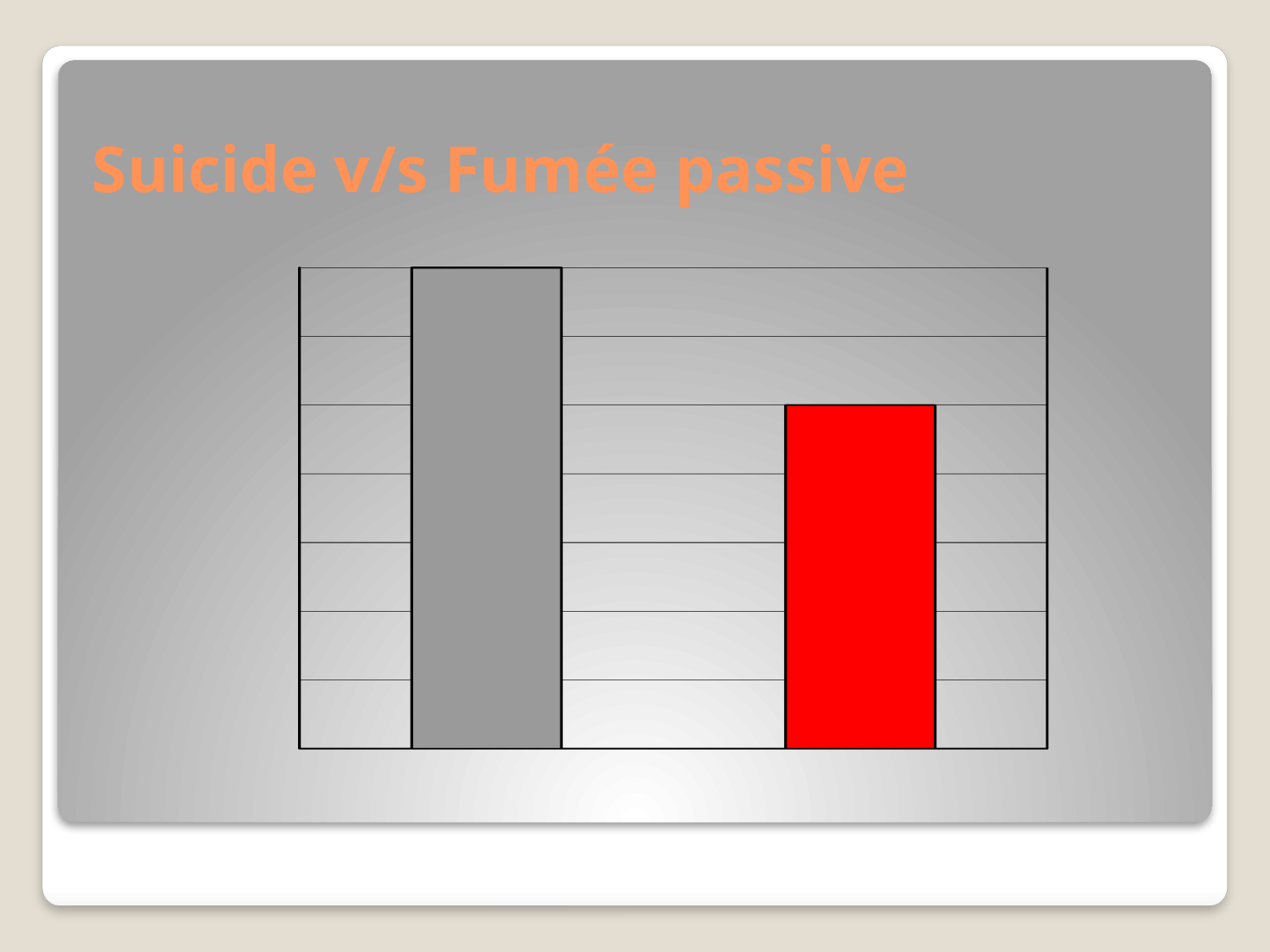
How many bars are plotted in the chart? 2 What is the title of the slide containing the chart? Suicide v/s Fumée passive Which bar is taller, the gray bar on the left or the red bar on the right? the gray bar on the left Which bar is the tallest in the chart? the gray bar on the left What colour is the bar on the right side of the chart? red Which bar is the shortest in the chart? the red bar on the right What kind of chart is shown on the slide? bar chart